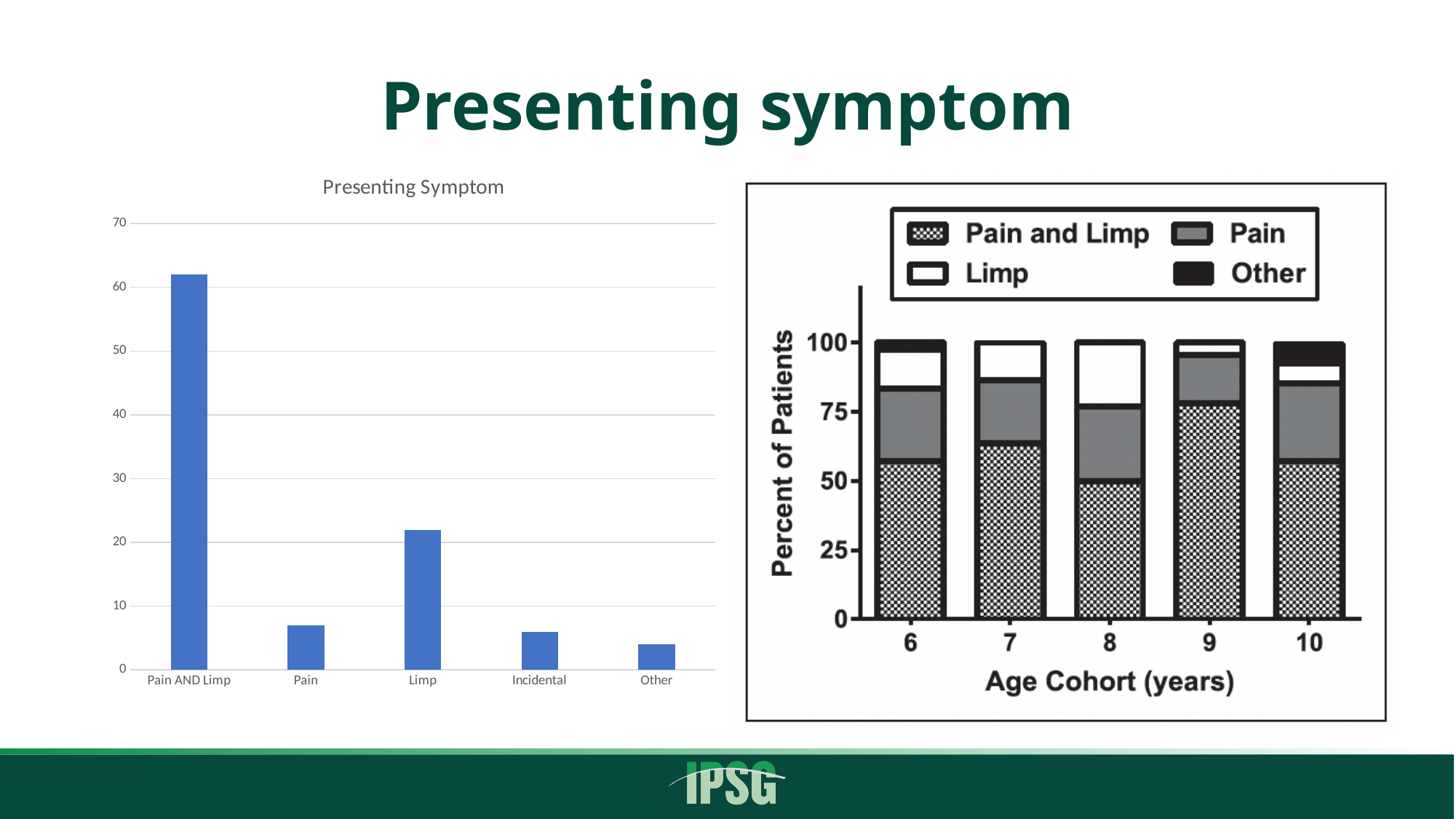
How many age cohorts are shown on the x axis of the right chart (Percent of Patients by Age Cohort)? 5 In the left "Presenting Symptom" chart, is the value for Limp greater or less than 20? greater In the left "Presenting Symptom" chart, is the value for Pain greater or less than 10? less In the left "Presenting Symptom" chart, which category has the highest value? Pain AND Limp In the left "Presenting Symptom" chart, which is larger, the value for Limp or the value for Incidental? Limp In the right chart (Percent of Patients by Age Cohort), is the Pain and Limp segment for age cohort 7 greater or less than 50? greater In the right chart (Percent of Patients by Age Cohort), which age cohort has the largest Other segment? 10 In the left "Presenting Symptom" chart, which category has the lowest value? Other What type of chart is the left chart titled "Presenting Symptom"? bar chart How many series does the legend of the right chart (Percent of Patients by Age Cohort) list? 4 How many categories are shown on the x axis of the left "Presenting Symptom" chart? 5